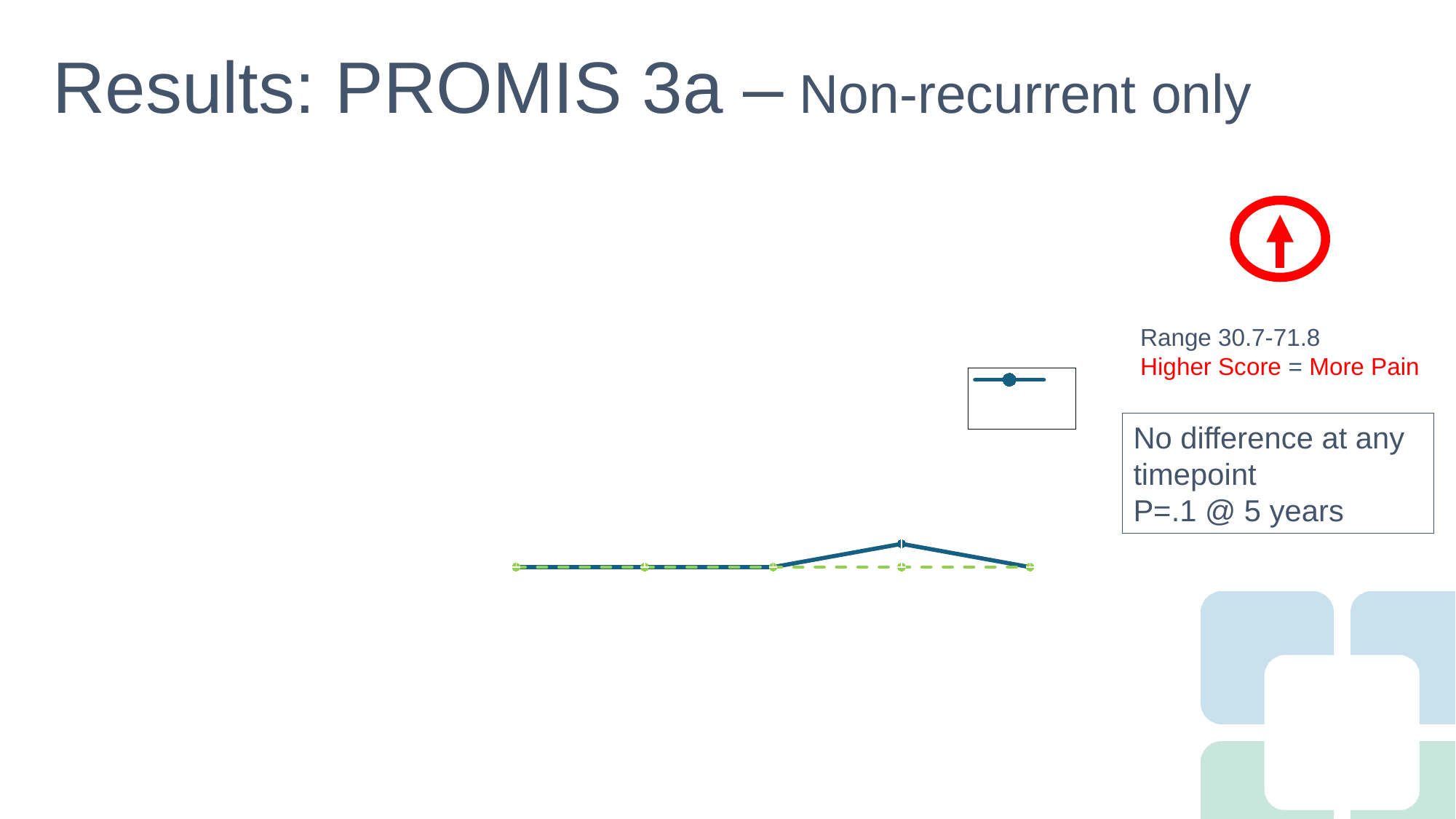
Does the dashed green line rise, fall, or stay flat across the x axis? stay flat What colour is the solid line on the chart? blue How many data points does each line on the chart have? 5 How many lines are plotted on the chart? 2 At which point from the left does the solid blue line reach its highest value? the fourth point What kind of chart is shown on the slide? line chart At the fourth point from the left, is the solid blue line above or below the dashed green line? above What line style is used for the green series? dashed